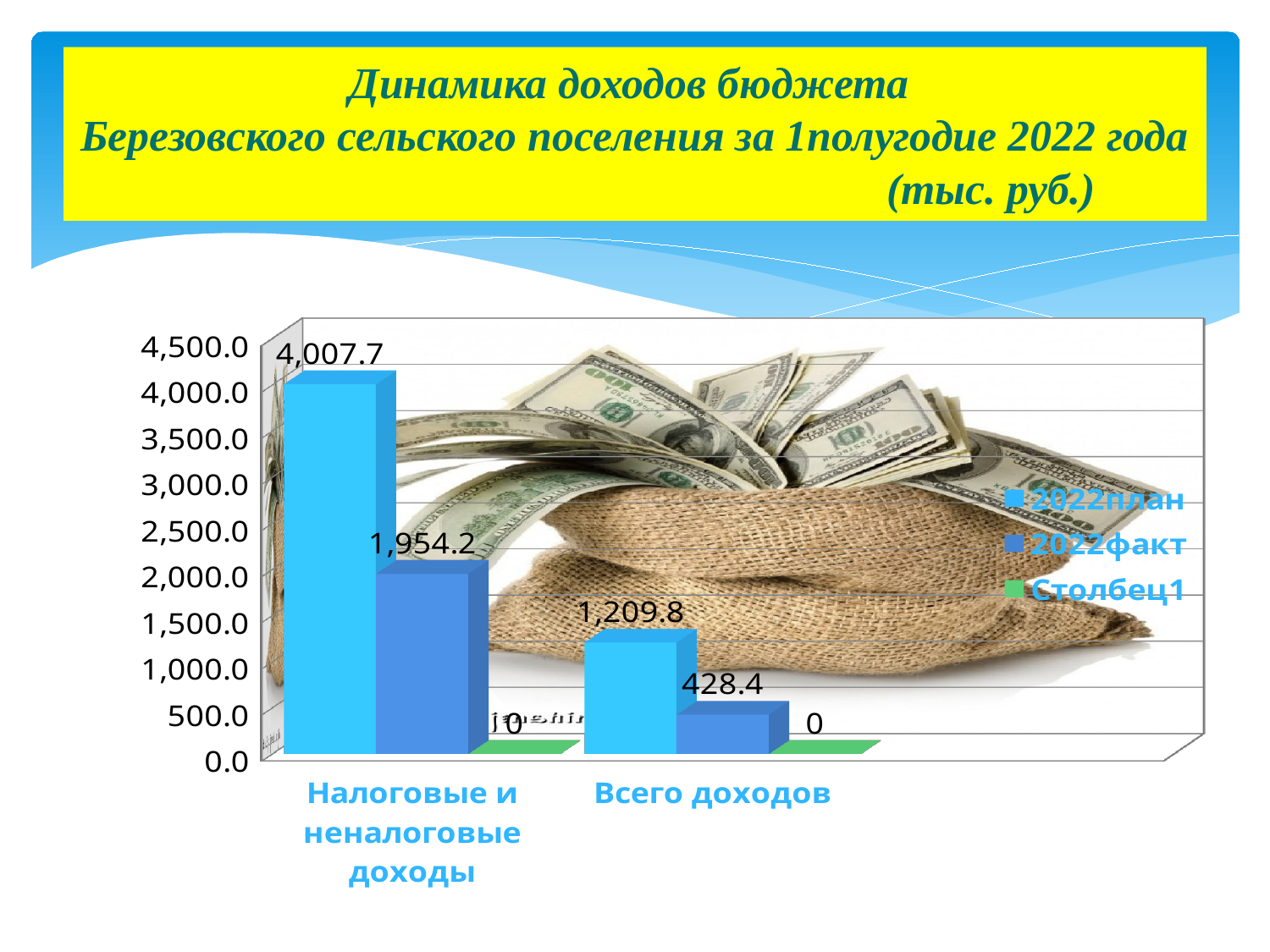
Which category has the highest 2022план value? Налоговые и неналоговые доходы What is the Столбец1 value for Всего доходов? 0 What is the difference between the 2022план and 2022факт values for Всего доходов? 781.4 Which is larger: the 2022факт value for Налоговые и неналоговые доходы or the 2022план value for Всего доходов? 2022факт value for Налоговые и неналоговые доходы Which category has the lowest 2022факт value? Всего доходов How many series does the legend list? 3 What is the 2022факт value for Всего доходов? 428.4 What is the 2022план value for Налоговые и неналоговые доходы? 4,007.7 What is the 2022план value for Всего доходов? 1,209.8 What is the 2022факт value for Налоговые и неналоговые доходы? 1,954.2 What kind of chart is shown on the slide? Bar chart What is the difference between the 2022план and 2022факт values for Налоговые и неналоговые доходы? 2,053.5